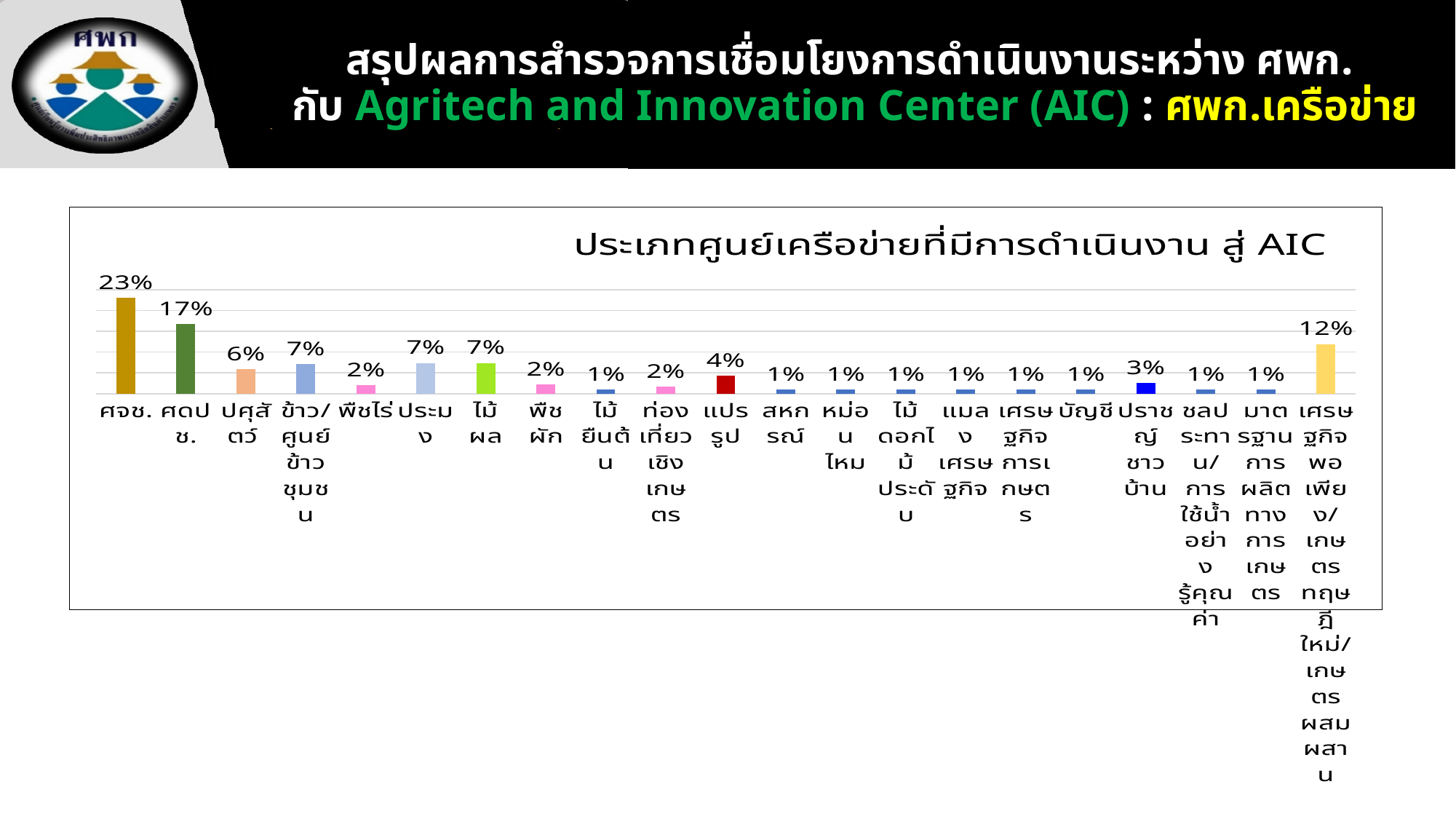
What is the title of the chart? ประเภทศูนย์เครือข่ายที่มีการดำเนินงาน สู่ AIC What is the value for ศดปช. in the chart? 17% How many categories are shown in the chart? 21 What is the value for ปราชญ์ชาวบ้าน in the chart? 3% Which is larger, the value for ไม้ผล or the value for แปรรูป? ไม้ผล What is the value for ปศุสัตว์ in the chart? 6% Which category has the highest value in the chart? ศจช. What is the difference between the values for ศจช. and ศดปช.? 6% What is the value for ศจช. in the chart? 23% What is the value for แปรรูป in the chart? 4% What is the difference between the values for ศดปช. and ปศุสัตว์? 11% What kind of chart is shown on the slide? Bar chart